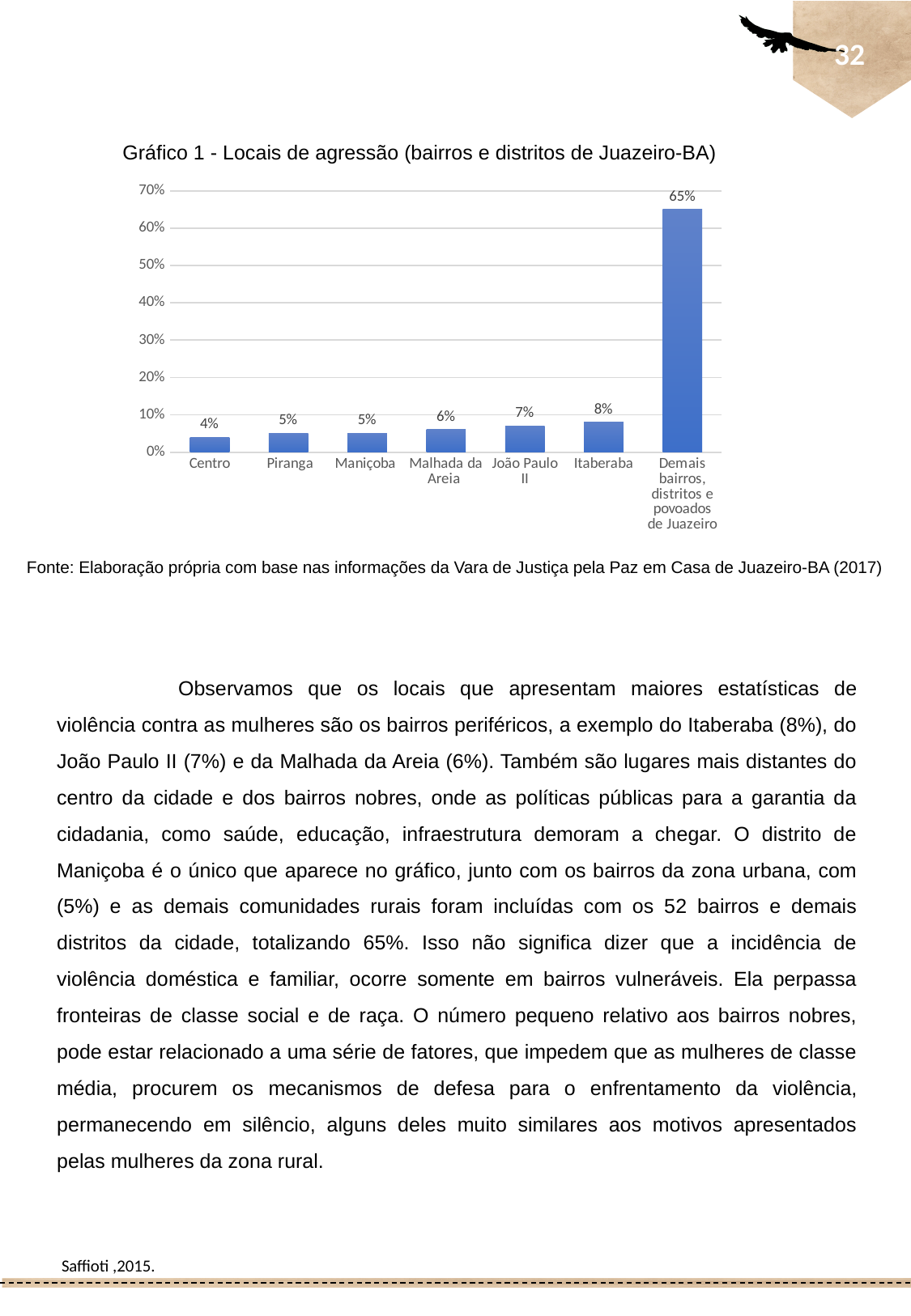
What is the difference between the values for Demais bairros, distritos e povoados de Juazeiro and João Paulo II? 58% How many categories are shown on the x axis? 7 What is the value for Malhada da Areia? 6% What is the title of the chart? Gráfico 1 - Locais de agressão (bairros e distritos de Juazeiro-BA) Is the value for Demais bairros, distritos e povoados de Juazeiro greater or less than 60%? greater What is the difference between the values for Itaberaba and Centro? 4% What kind of chart is shown? bar chart Which category has the lowest value? Centro Which is larger, the value for João Paulo II or the value for Piranga? João Paulo II What is the value for Centro? 4% Which category has the highest value? Demais bairros, distritos e povoados de Juazeiro What is the value for Itaberaba? 8%